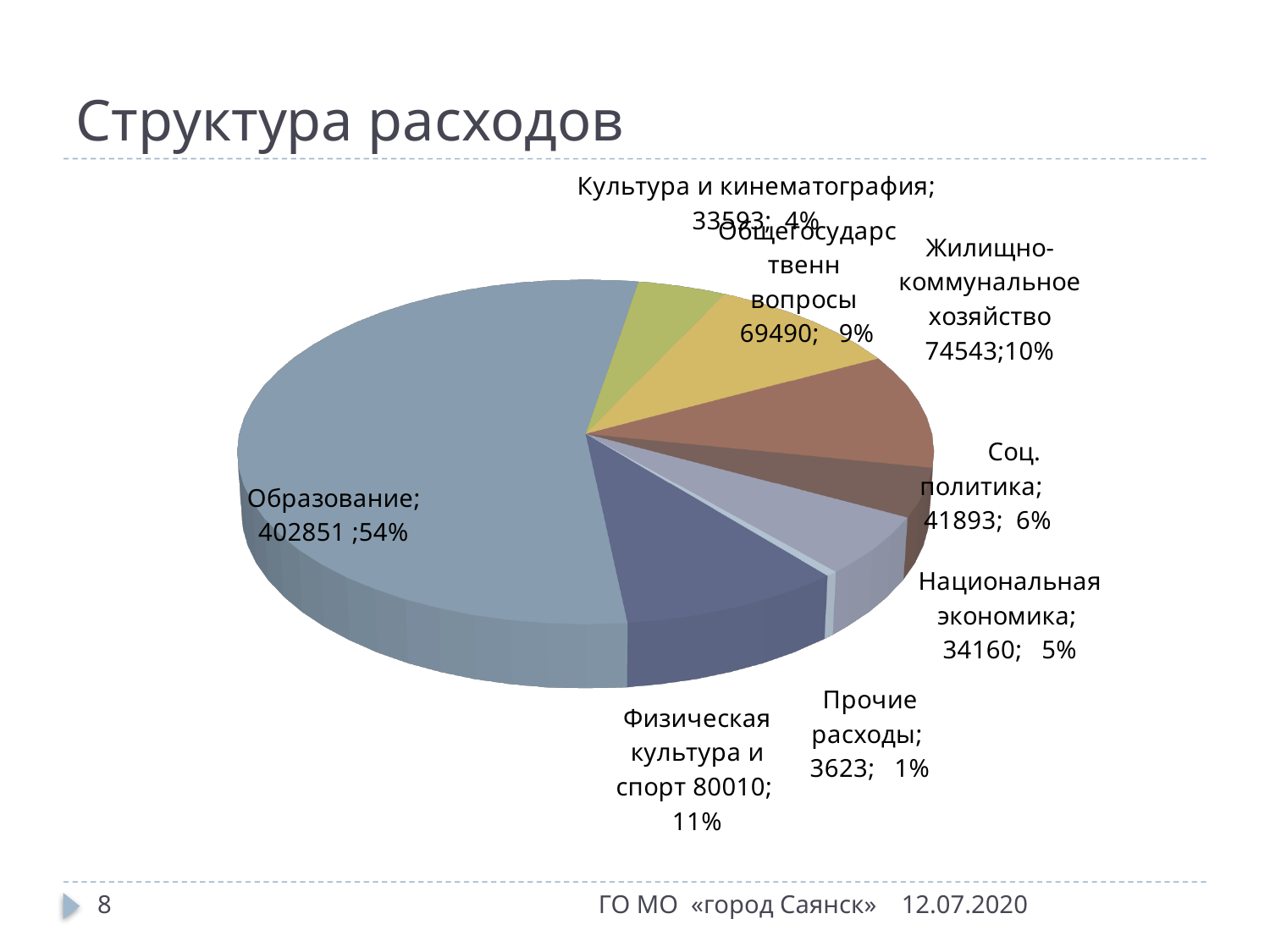
What is the difference between the values for Жилищно-коммунальное хозяйство and Общегосударственные вопросы? 5053 What is the value shown for Физическая культура и спорт? 80010 What is the value shown for Прочие расходы? 3623 What share of the pie does Образование take? 54% Which category has the smallest slice of the pie? Прочие расходы How many slices does the pie chart have? 8 Which category has the largest slice of the pie? Образование What is the value shown for Образование? 402851 Which is larger, Соц. политика or Национальная экономика? Соц. политика What kind of chart is shown on the slide? pie chart What share of the pie does Жилищно-коммунальное хозяйство take? 10% What is the title of the slide with the pie chart? Структура расходов